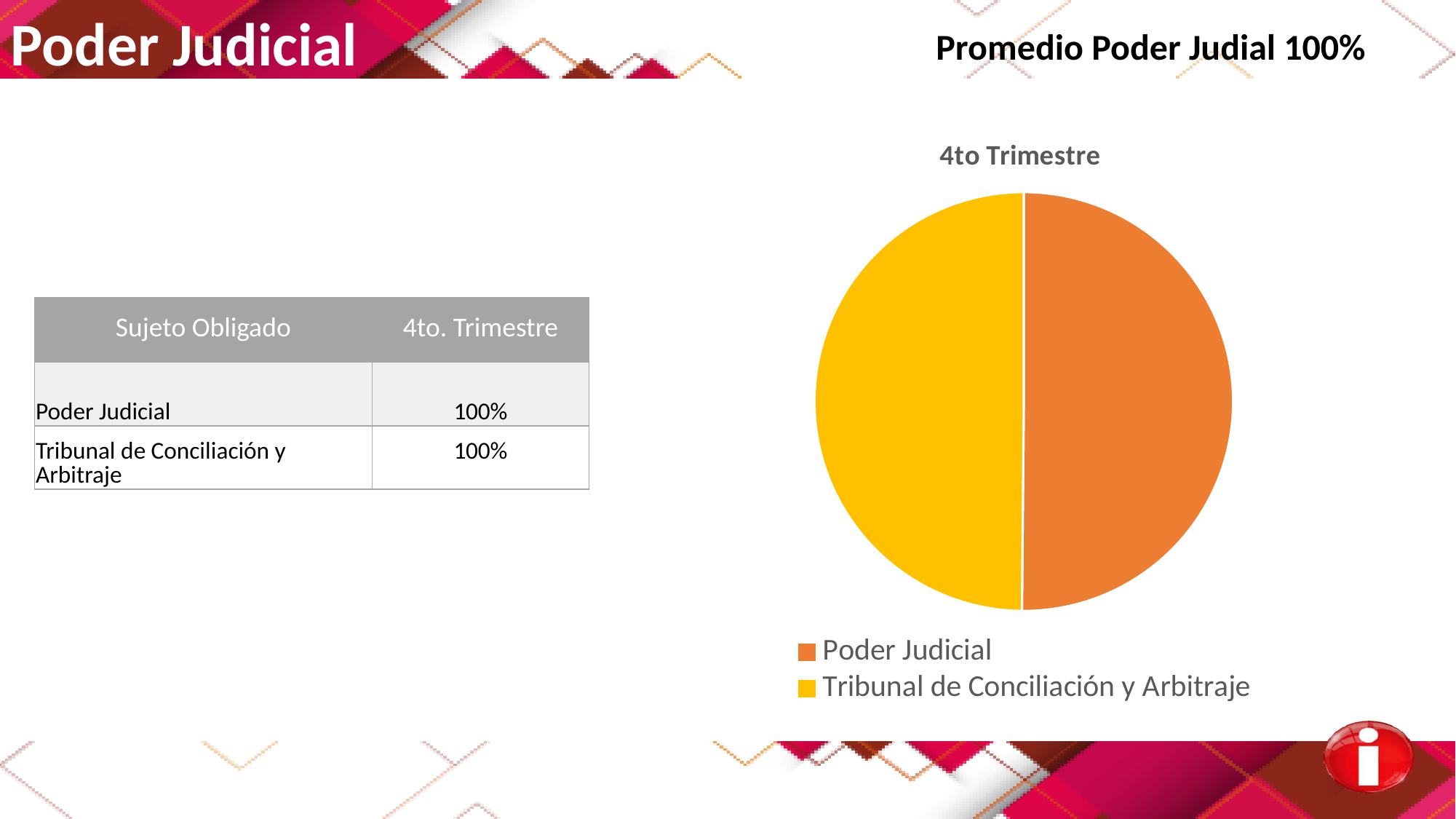
What kind of chart is shown on the slide? pie chart How many slices does the pie chart have? 2 How many entries does the pie chart's legend list? 2 What is the title of the pie chart? 4to Trimestre What is the difference between the table values for Poder Judicial and Tribunal de Conciliación y Arbitraje? 0% According to the table, what is the 4to. Trimestre value for Poder Judicial? 100% Which category is shown in orange in the pie chart? Poder Judicial According to the table, what is the 4to. Trimestre value for Tribunal de Conciliación y Arbitraje? 100%